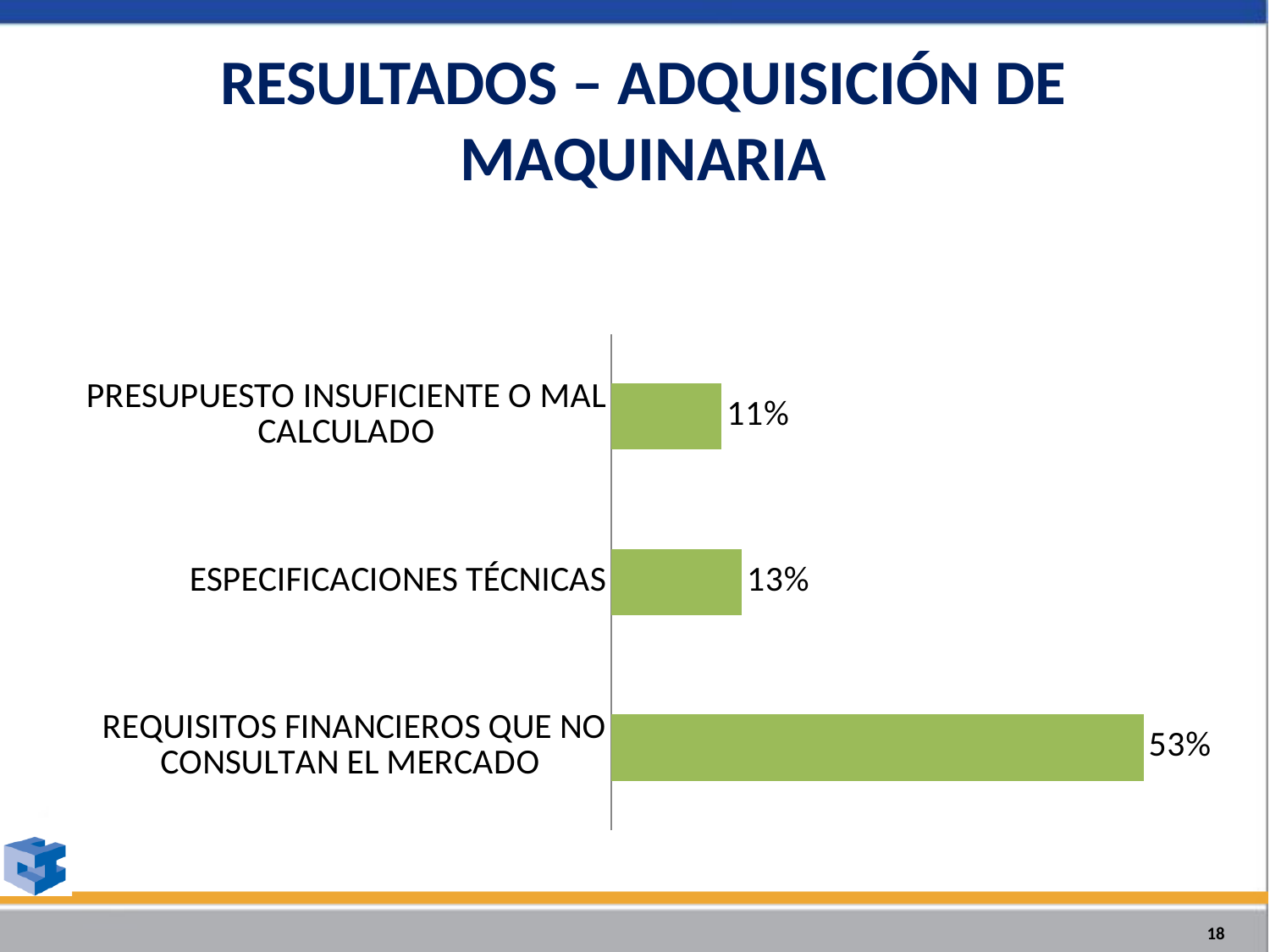
What is the value for PRESUPUESTO INSUFICIENTE O MAL CALCULADO? 11% Which category has the highest value? REQUISITOS FINANCIEROS QUE NO CONSULTAN EL MERCADO How many categories are shown in the chart? 3 What is the difference between the values for ESPECIFICACIONES TÉCNICAS and PRESUPUESTO INSUFICIENTE O MAL CALCULADO? 2% Which category has the lowest value? PRESUPUESTO INSUFICIENTE O MAL CALCULADO What colour are the bars in the chart? Green What is the title of the slide containing the chart? RESULTADOS – ADQUISICIÓN DE MAQUINARIA What is the difference between the values for REQUISITOS FINANCIEROS QUE NO CONSULTAN EL MERCADO and ESPECIFICACIONES TÉCNICAS? 40% What is the value for ESPECIFICACIONES TÉCNICAS? 13% What is the value for REQUISITOS FINANCIEROS QUE NO CONSULTAN EL MERCADO? 53% Which is larger, the value for ESPECIFICACIONES TÉCNICAS or the value for PRESUPUESTO INSUFICIENTE O MAL CALCULADO? ESPECIFICACIONES TÉCNICAS What kind of chart is shown on the slide? Bar chart